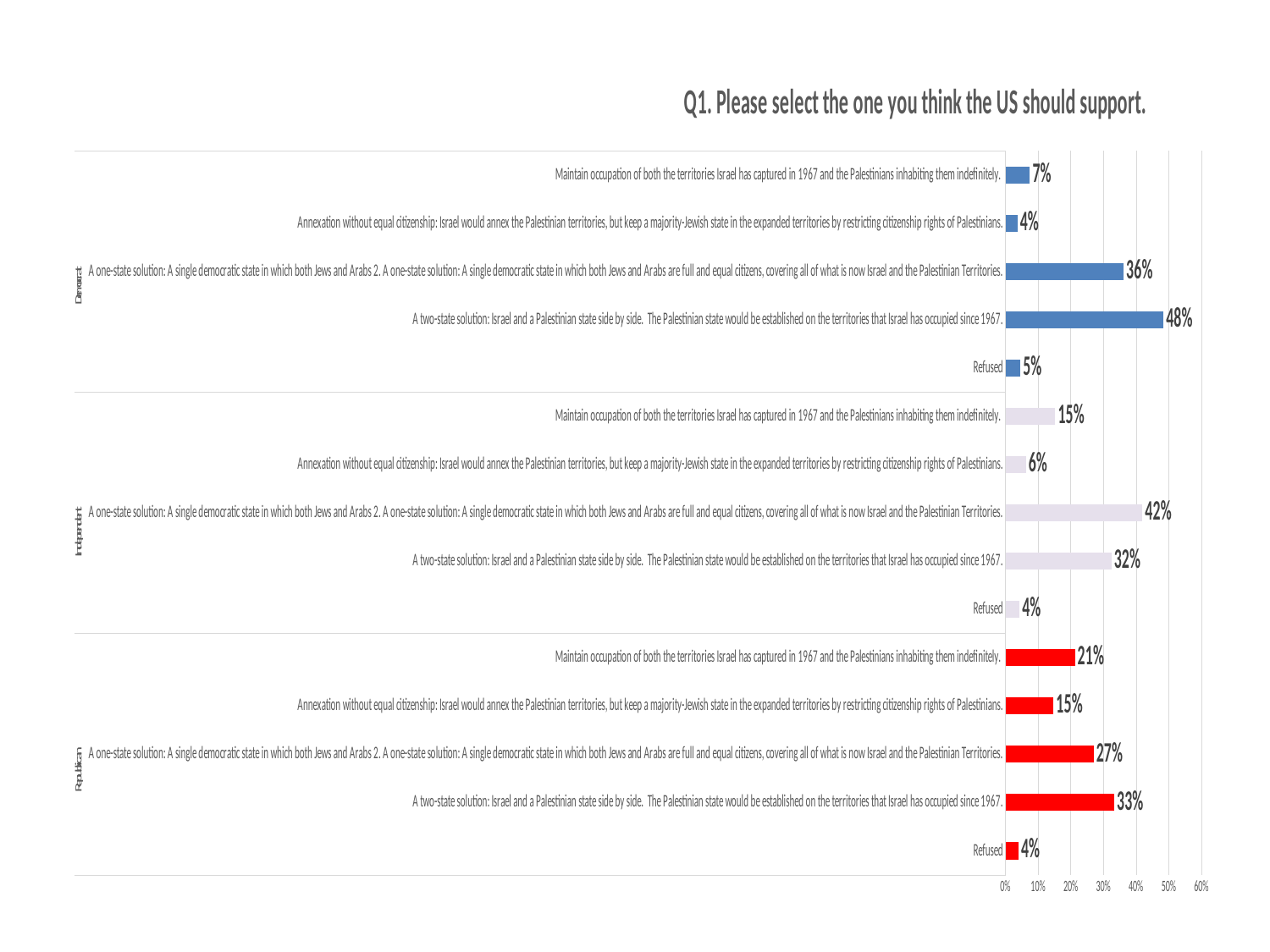
How many response options are shown for each party group? 5 Which is larger: the Independent percentage for the one-state solution or the Independent percentage for the two-state solution? One-state solution What percentage of Independents selected the one-state solution? 42% What is the title of the chart? Q1. Please select the one you think the US should support. What colour are the bars for the Republican group? Red What is the difference between the Democrat and Republican percentages for the two-state solution? 15% Among Democrats, which option has the lowest percentage? Annexation without equal citizenship What type of chart is shown on the slide? Bar chart Is the Democrat value for the two-state solution greater or less than 40%? greater What percentage of Republicans selected 'Maintain occupation of both the territories Israel has captured in 1967 and the Palestinians inhabiting them indefinitely'? 21% Among Republicans, which option has the highest percentage? A two-state solution What percentage of Democrats selected the two-state solution? 48%